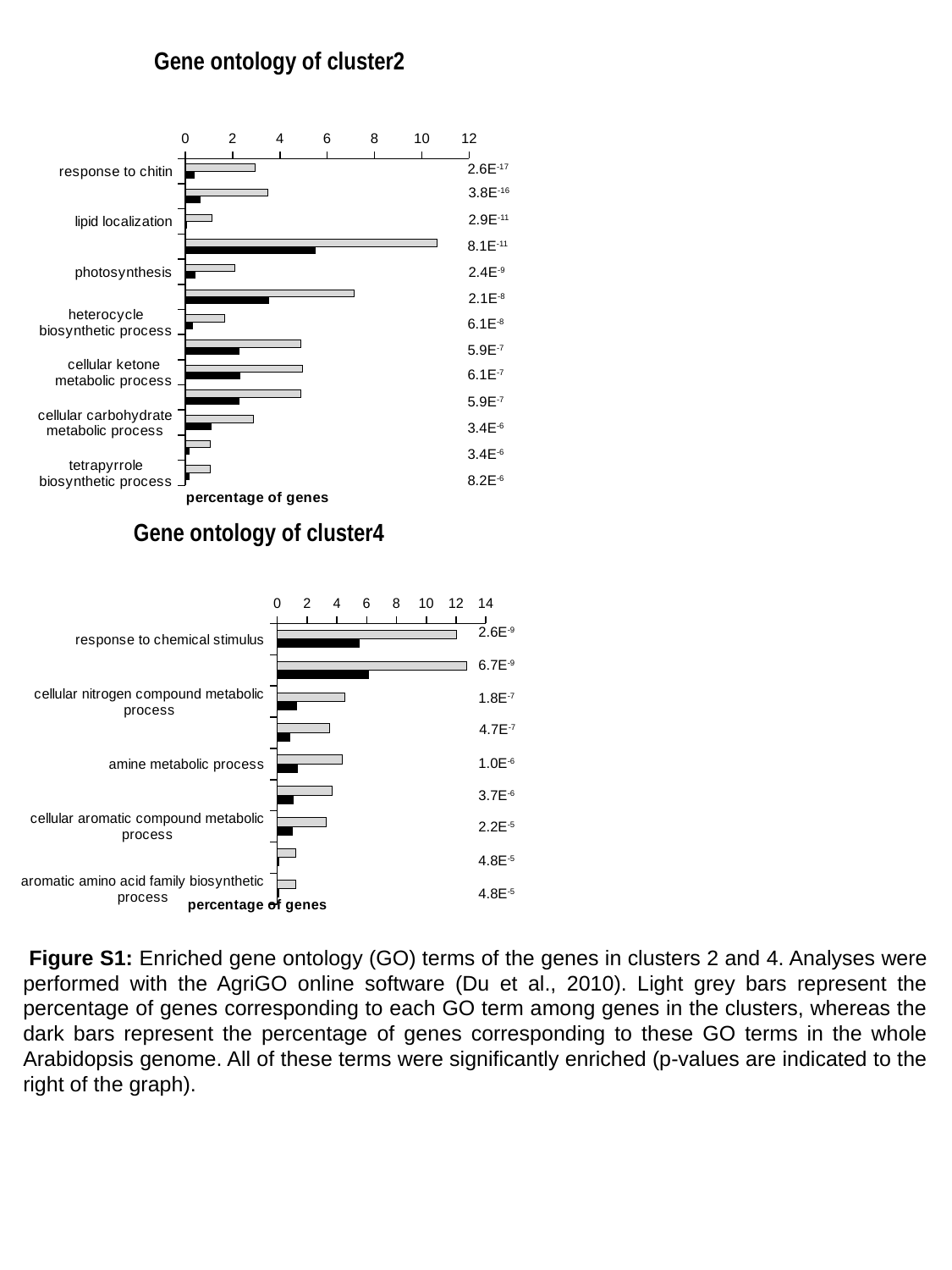
In the 'Gene ontology of cluster4' chart, is the light grey bar for 'amine metabolic process' greater or less than 6? less What kind of chart is 'Gene ontology of cluster2'? bar chart In the 'Gene ontology of cluster4' chart, which labeled GO term has the longest light grey bar? response to chemical stimulus What is the x-axis label of the 'Gene ontology of cluster2' chart? percentage of genes In the 'Gene ontology of cluster2' chart, which has the longer light grey bar: 'response to chitin' or 'lipid localization'? response to chitin In the 'Gene ontology of cluster2' chart, what p-value is printed next to 'response to chitin'? 2.6E-17 How many GO term labels are printed on the y axis of the 'Gene ontology of cluster4' chart? 5 How many p-values are listed to the right of the 'Gene ontology of cluster2' chart? 13 In the 'Gene ontology of cluster2' chart, is the light grey bar for 'lipid localization' greater or less than 2? less In the 'Gene ontology of cluster4' chart, is the light grey bar for 'response to chemical stimulus' greater or less than 10? greater In the 'Gene ontology of cluster4' chart, what p-value is printed next to 'response to chemical stimulus'? 2.6E-9 In the 'Gene ontology of cluster4' chart, what p-value is printed next to 'amine metabolic process'? 1.0E-6